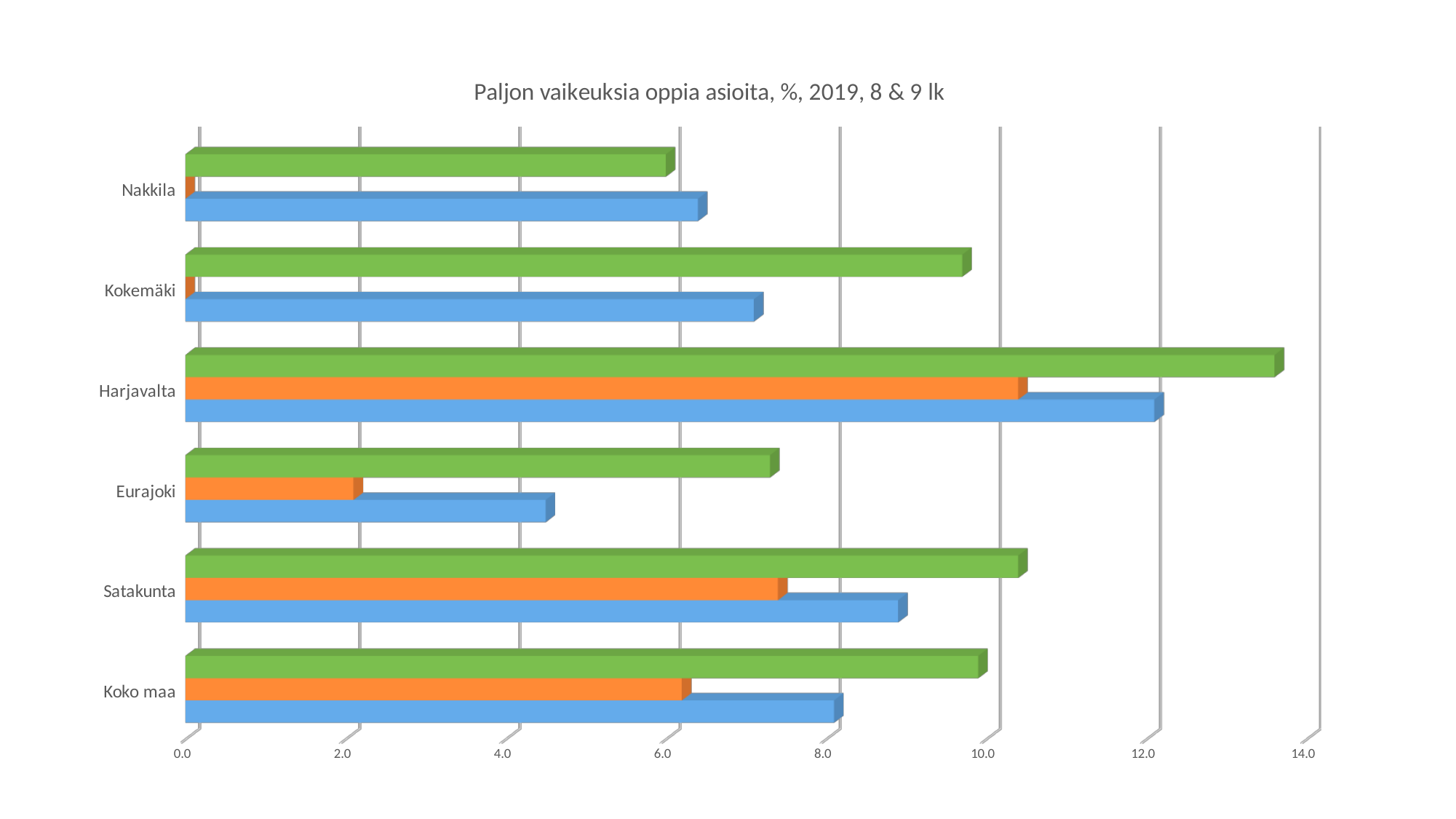
What kind of chart is shown on the slide? bar chart Which category has the longest blue bar? Harjavalta Which category has the shortest green bar? Nakkila Which category has the longest green bar? Harjavalta Is the green bar for Kokemäki greater or less than 8.0? greater How many categories are shown on the vertical axis of the chart? 6 Which category has the shortest blue bar? Eurajoki For Harjavalta, which is longer: the green bar or the blue bar? the green bar Is the green bar for Harjavalta greater or less than 12.0? greater What is the title of the chart? Paljon vaikeuksia oppia asioita, %, 2019, 8 & 9 lk Is the blue bar for Eurajoki greater or less than 6.0? less How many bars are plotted for each category in the chart? 3